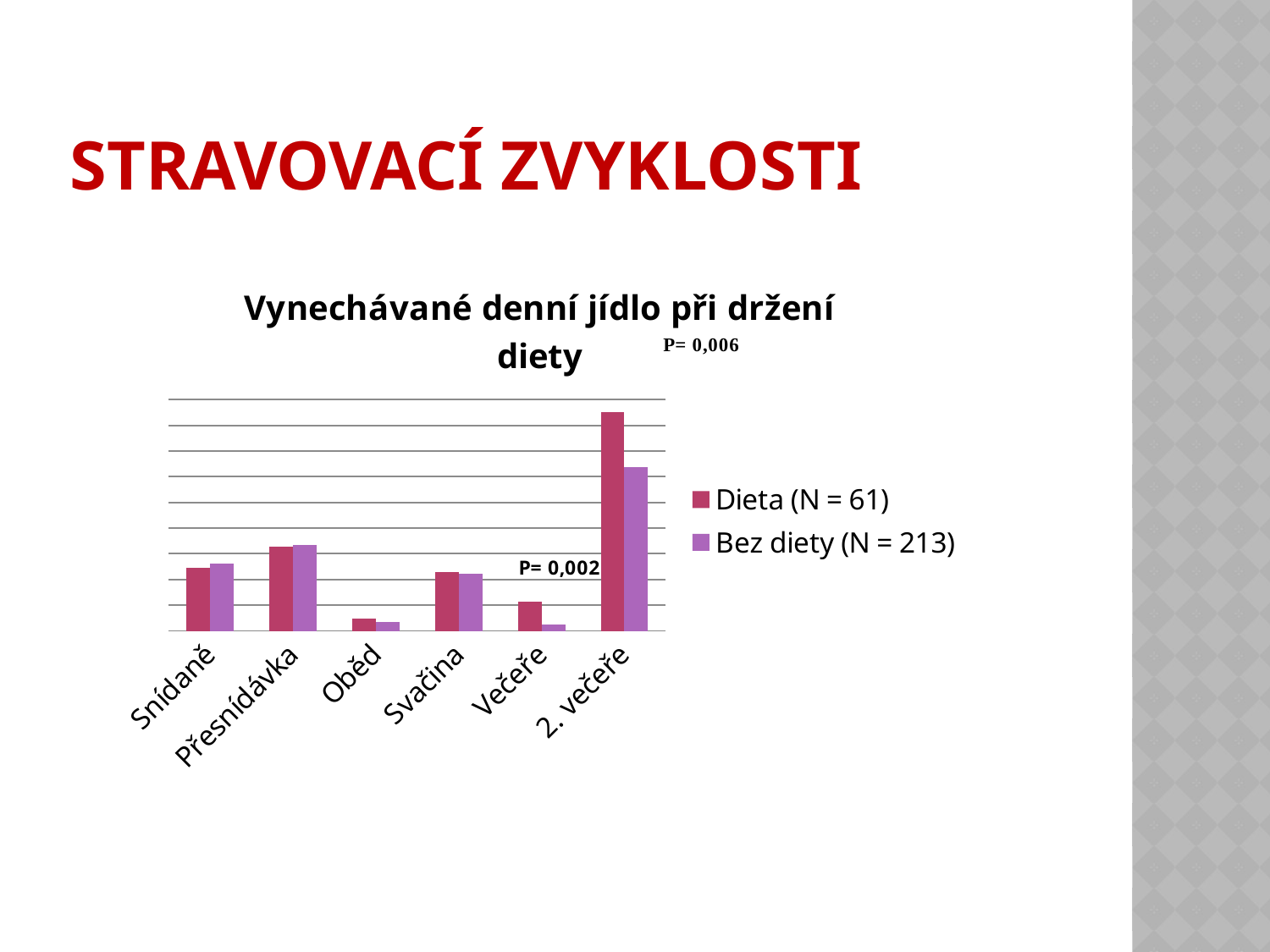
How many categories are shown on the x axis of the chart? 6 For Večeře, which series has the larger value: Dieta (N = 61) or Bez diety (N = 213)? Dieta (N = 61) What is the title of the chart? Vynechávané denní jídlo při držení diety In the Dieta (N = 61) series, which is larger: Snídaně or Přesnídávka? Přesnídávka For 2. večeře, which series has the larger value: Dieta (N = 61) or Bez diety (N = 213)? Dieta (N = 61) How many series does the chart legend list? 2 Which category has the lowest value for the Bez diety (N = 213) series? Večeře What kind of chart is shown on the slide? Bar chart Which category has the lowest value for the Dieta (N = 61) series? Oběd Which category has the highest value for the Dieta (N = 61) series? 2. večeře What P value is printed next to the Večeře bars? P= 0,002 Which category has the highest value for the Bez diety (N = 213) series? 2. večeře